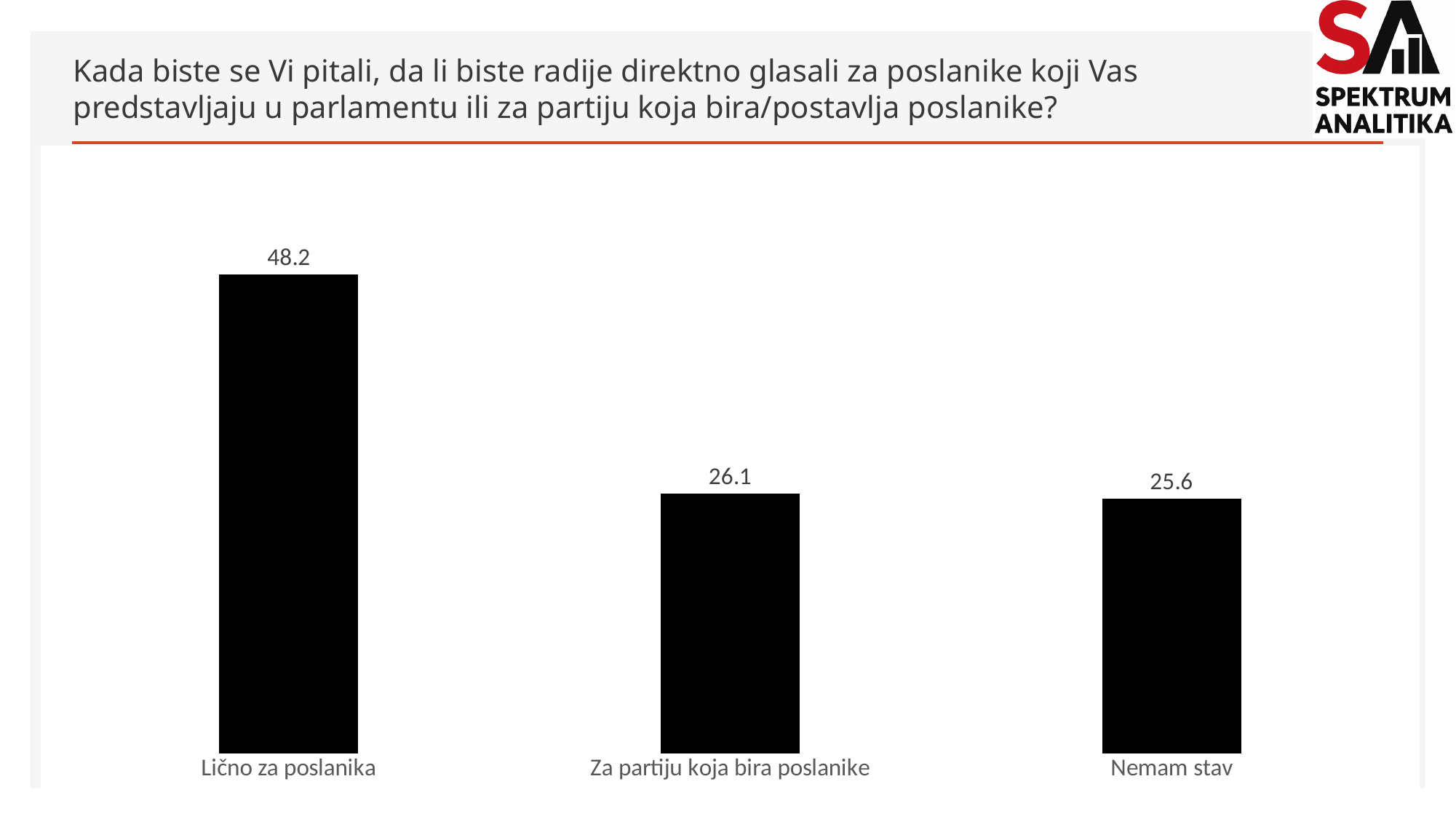
Which category has the highest value? Lično za poslanika What is the difference between the values for "Za partiju koja bira poslanike" and "Nemam stav"? 0.5 What is the label of the rightmost bar? Nemam stav What colour are the bars in the chart? Black What is the value for "Za partiju koja bira poslanike"? 26.1 What is the value for "Nemam stav"? 25.6 What is the value for "Lično za poslanika"? 48.2 How many categories are shown in the chart? 3 Which is larger, the value for "Lično za poslanika" or the value for "Nemam stav"? Lično za poslanika What is the difference between the values for "Lično za poslanika" and "Za partiju koja bira poslanike"? 22.1 What kind of chart is shown on the slide? Bar chart